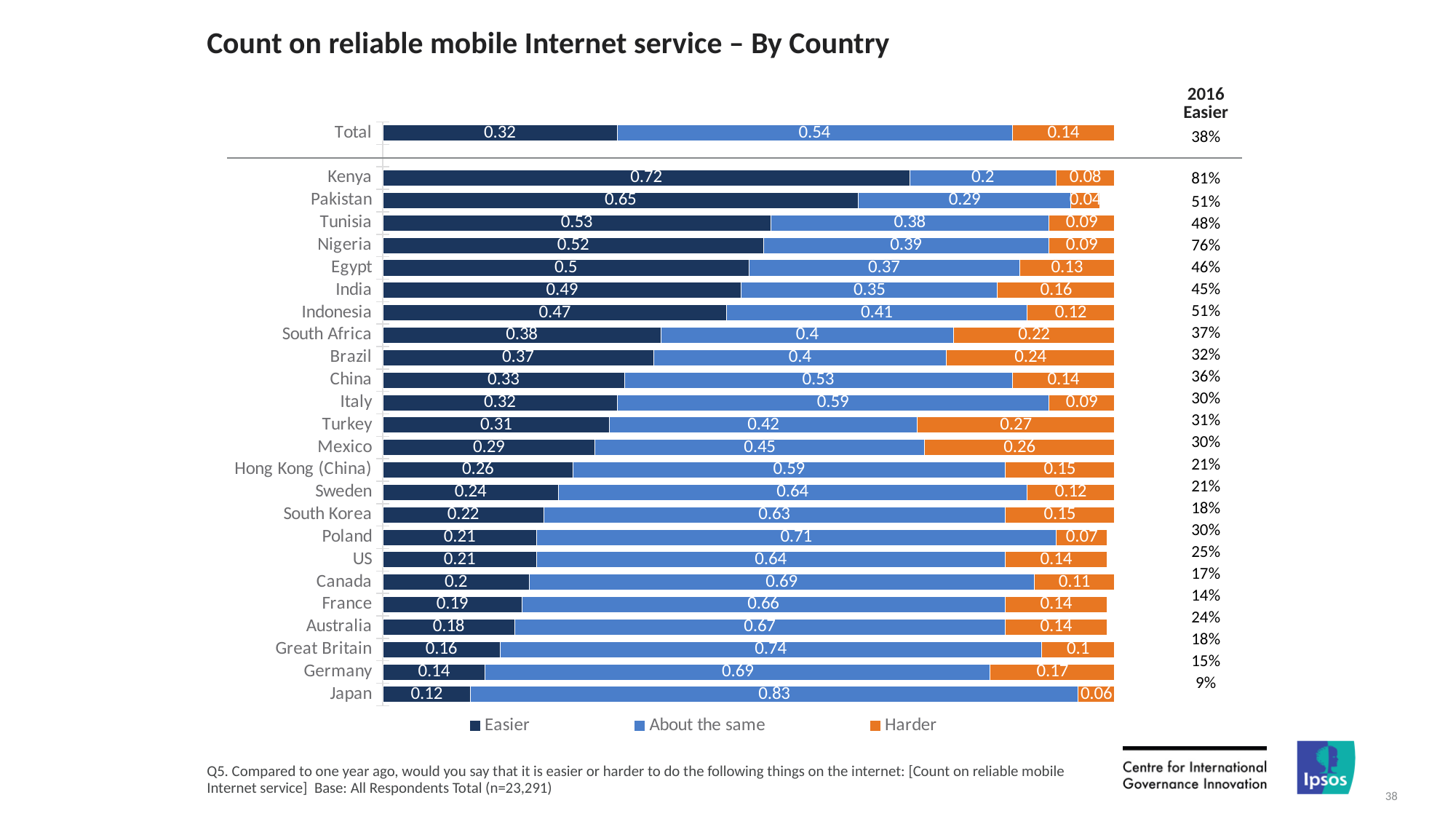
How many series does the legend list? 3 How many countries are listed in the chart, excluding the Total row? 24 Which country has the highest About the same value? Japan What is the About the same value for Poland? 0.71 What is the Easier value for Egypt? 0.5 What kind of chart is shown on the slide? Stacked bar chart Which country has the highest Easier value? Kenya What is the difference between the Easier values for Kenya and Japan? 0.6 What is the Harder value for Germany? 0.17 What is the 2016 Easier percentage shown for Nigeria? 76% Which country has the lowest Easier value? Japan Which has a larger Harder value, Brazil or Italy? Brazil